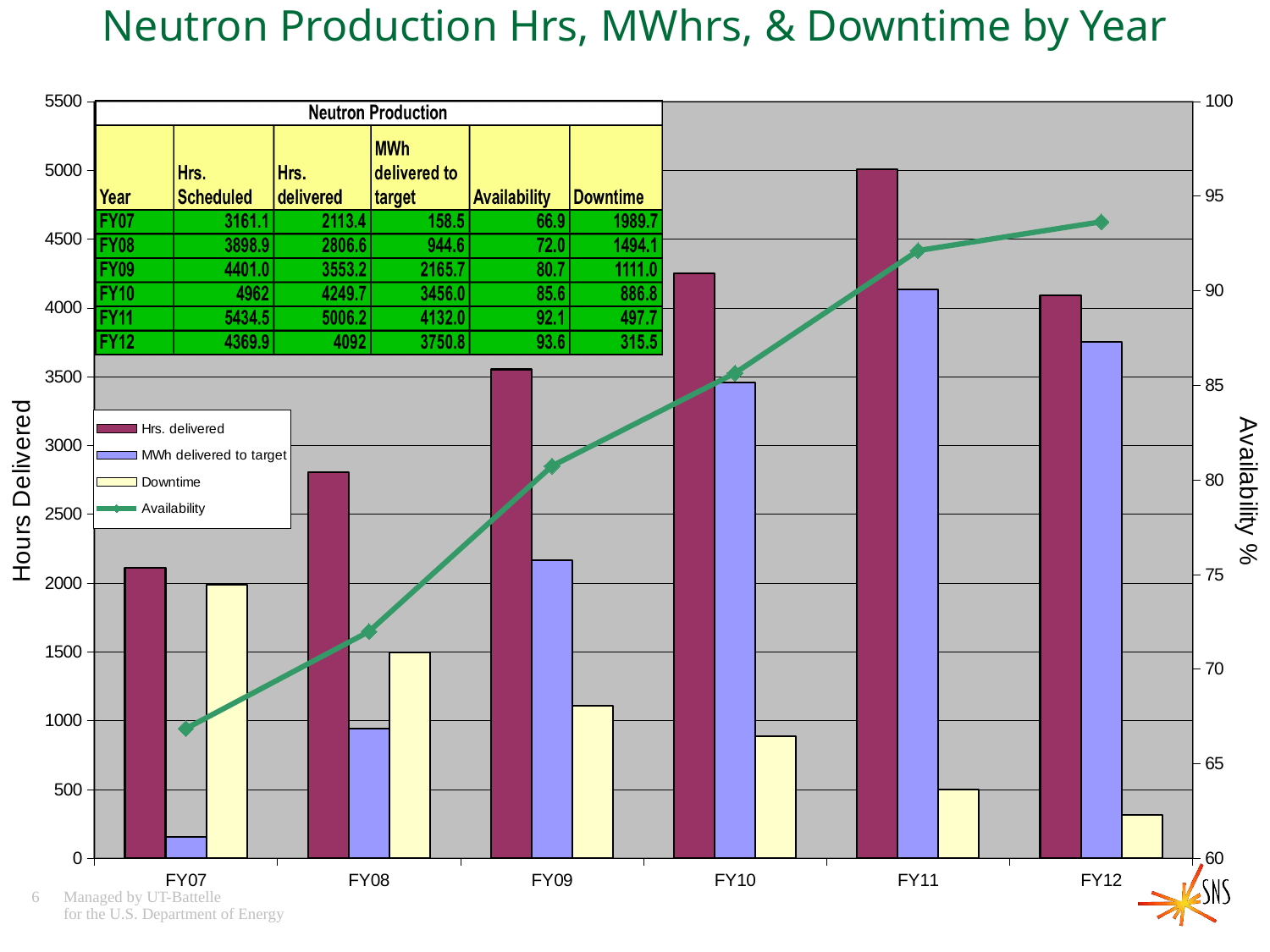
How many series does the legend list? 4 Which is larger, MWh delivered to target in FY10 or in FY12? FY12 What kind of chart is shown on the slide? Bar chart with a line What is the Availability value for FY10? 85.6 What is the Hrs. delivered value for FY11? 5006.2 Which year has the highest Hrs. delivered? FY11 How many fiscal years are shown on the x axis? 6 Which year has the lowest Downtime? FY12 What is the difference in Downtime between FY07 and FY08? 495.6 What is the Downtime value for FY12? 315.5 Does Availability rise or fall from FY07 to FY12? Rise What is the MWh delivered to target value for FY09? 2165.7